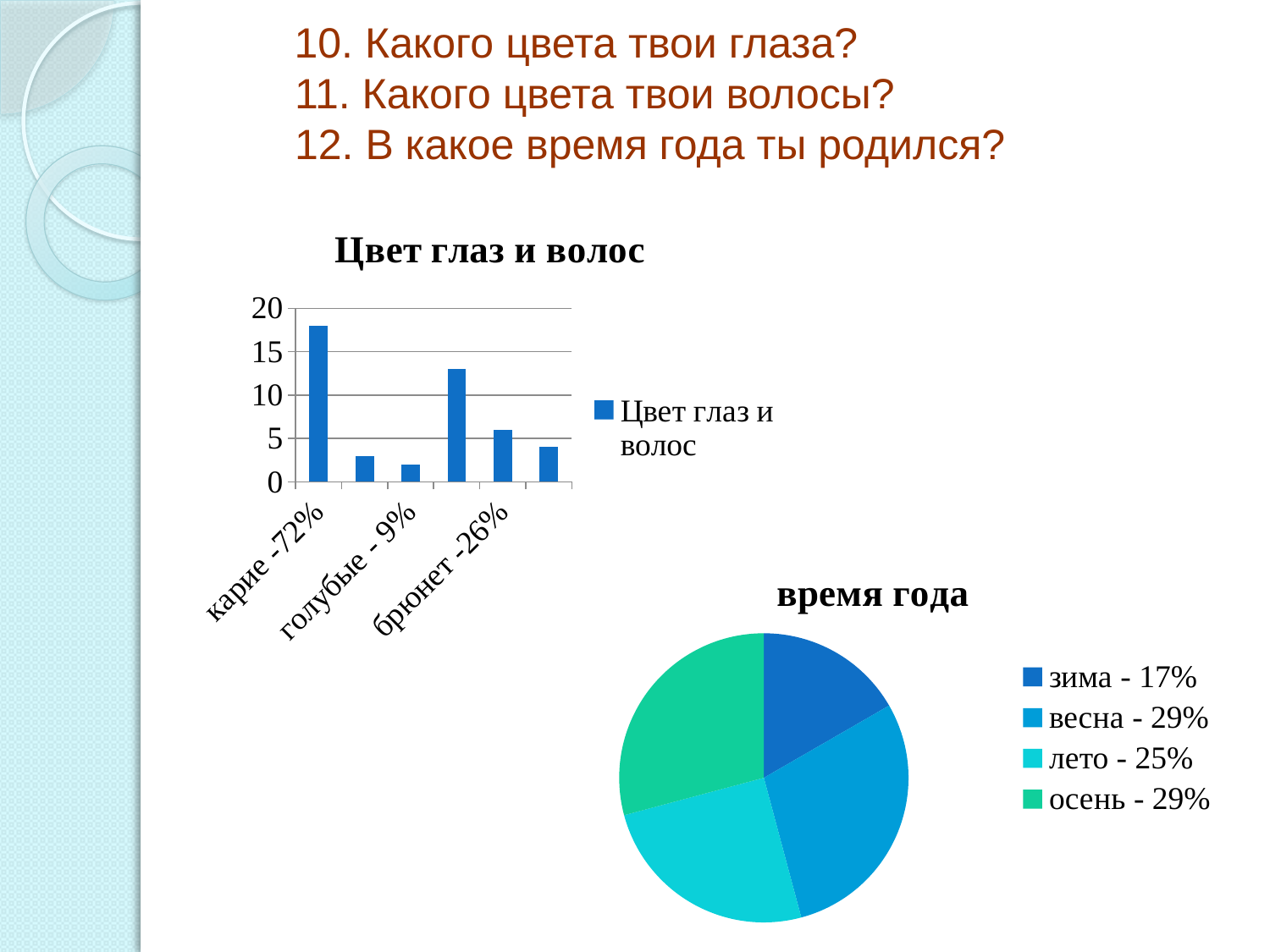
How many entries does the legend of the "время года" pie chart list? 4 In the "Цвет глаз и волос" chart, is the value for "карие -72%" greater or less than 15? greater In the "Цвет глаз и волос" chart, which category has the highest bar? карие -72% In the "время года" pie chart, which season has the smallest share? зима - 17% What kind of chart is the "время года" chart? pie chart In the "время года" pie chart, what is the difference between the shares of "весна" and "зима"? 12% In the "Цвет глаз и волос" chart, is the value for "голубые - 9%" greater or less than 5? less In the "время года" pie chart, what share does "зима" have? 17% In the "Цвет глаз и волос" chart, which is larger: the bar for "карие -72%" or the bar for "брюнет -26%"? карие -72% What kind of chart is the "Цвет глаз и волос" chart? bar chart In the "Цвет глаз и волос" chart, how many bars are plotted? 6 In the "Цвет глаз и волос" chart, is the value for "брюнет -26%" greater or less than 10? less